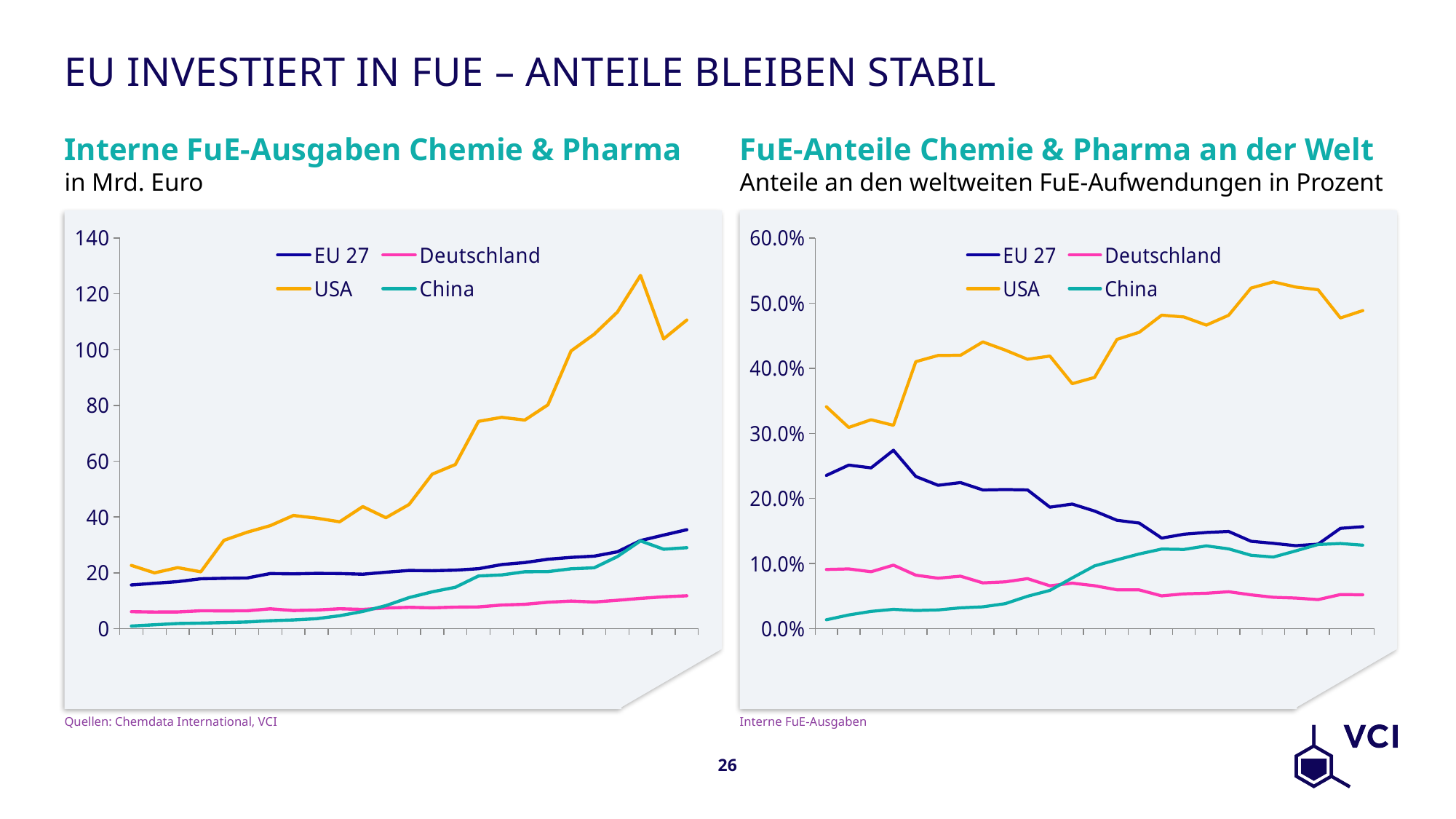
In the right chart, "FuE-Anteile Chemie & Pharma an der Welt", does the EU 27 line rise or fall overall along the x axis? fall In the right chart, "FuE-Anteile Chemie & Pharma an der Welt", does the USA line rise or fall overall along the x axis? rise In the left chart, "Interne FuE-Ausgaben Chemie & Pharma", is the peak value of the USA line greater or less than 120? greater In the right chart, "FuE-Anteile Chemie & Pharma an der Welt", is the first value of the EU 27 line greater or less than 20.0%? greater In the right chart, "FuE-Anteile Chemie & Pharma an der Welt", which is larger at the right end of the x axis, the USA line or the EU 27 line? USA In the right chart, "FuE-Anteile Chemie & Pharma an der Welt", is the last value of the China line greater or less than 10.0%? greater Which series are listed in the legend of the left chart, "Interne FuE-Ausgaben Chemie & Pharma"? EU 27, Deutschland, USA, China How many series does the legend of the right chart, "FuE-Anteile Chemie & Pharma an der Welt", list? 4 In the left chart, "Interne FuE-Ausgaben Chemie & Pharma", which series has the lowest values at the right end of the x axis? Deutschland What kind of chart is the left chart, "Interne FuE-Ausgaben Chemie & Pharma"? line chart In the left chart, "Interne FuE-Ausgaben Chemie & Pharma", which series has the highest values at the right end of the x axis? USA